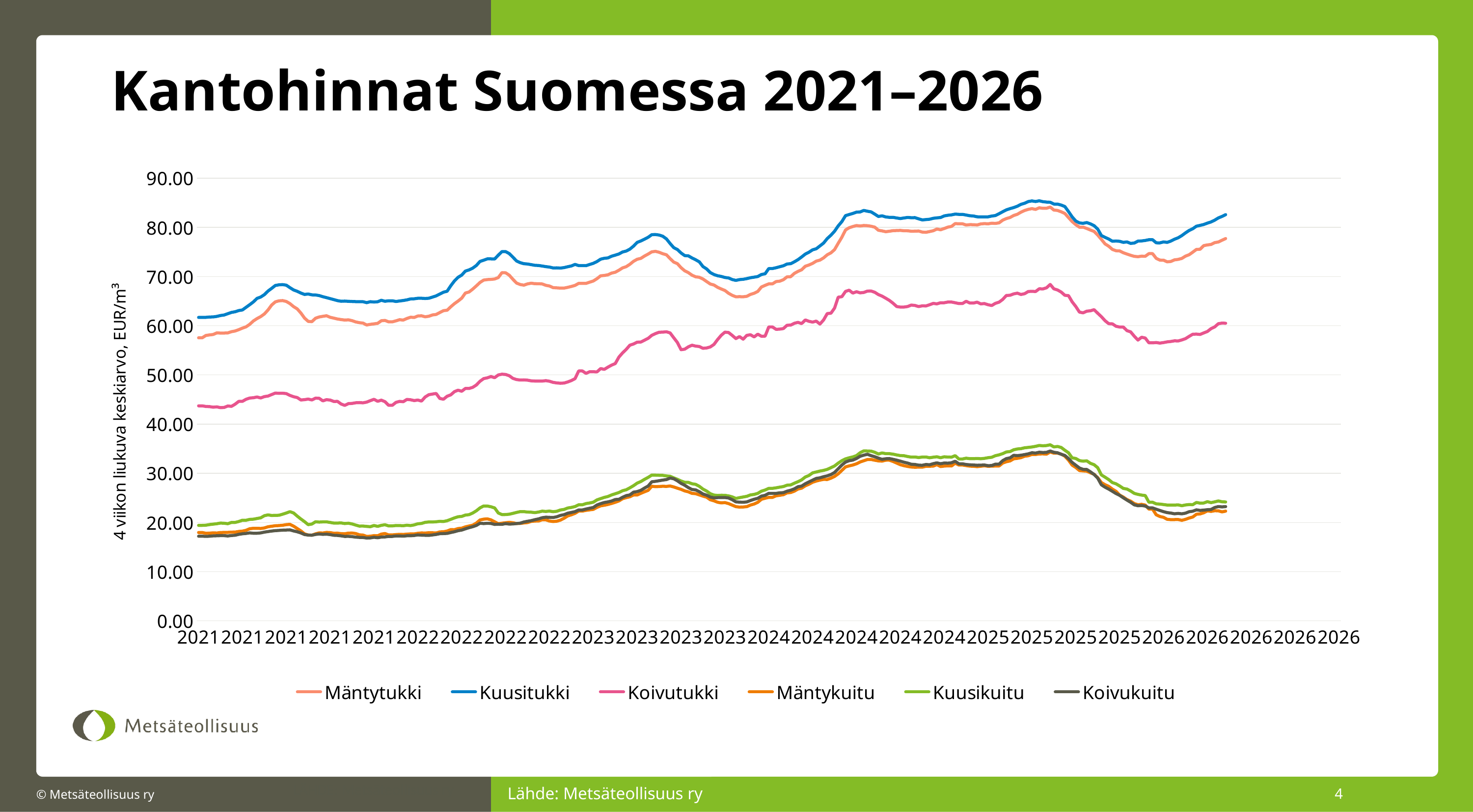
Which is larger throughout the chart: Koivutukki or Kuusikuitu? Koivutukki What kind of chart is shown on the slide? line chart What is the label on the vertical axis? 4 viikon liukuva keskiarvo, EUR/m³ Does the Koivutukki series rise or fall overall from the start of 2021 to the start of 2025? rise How many series does the legend list? 6 Is the value for Koivutukki at the start of 2021 greater or less than 50.00? less Is the peak value for Kuusitukki in 2025 greater or less than 80.00? greater Is the peak value for Kuusikuitu in 2025 greater or less than 30.00? greater What is the title of the chart? Kantohinnat Suomessa 2021–2026 At the start of 2021, which is larger: Kuusitukki or Mäntytukki? Kuusitukki Which series has the highest values across the whole chart? Kuusitukki